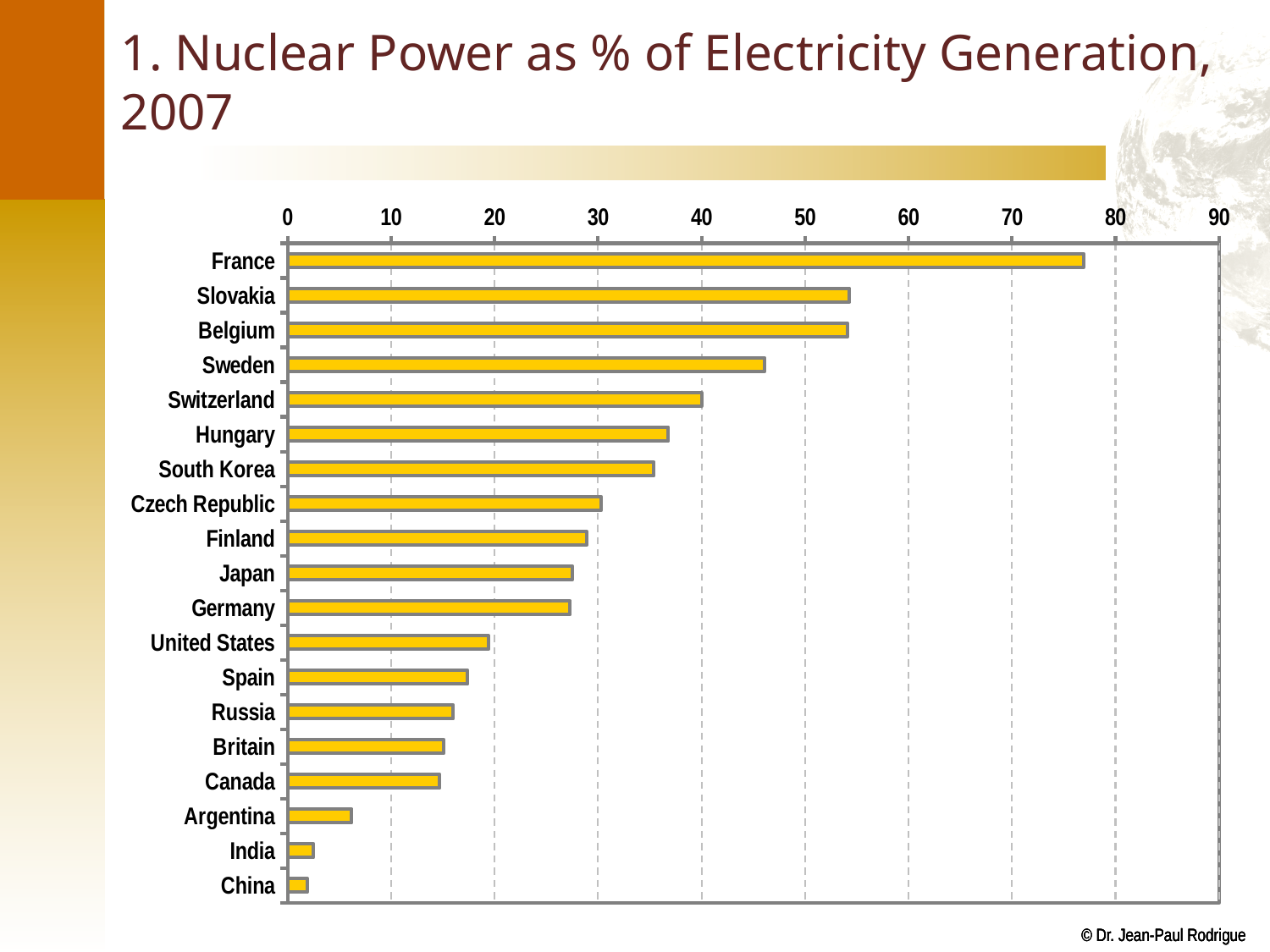
Do the bar values rise or fall going from the top of the chart to the bottom? fall Is the value for Spain greater or less than 20? less Which has a larger value, Sweden or Hungary? Sweden Is the value for Hungary greater or less than 40? less Which has a larger value, Argentina or Canada? Canada Is the value for Argentina greater or less than 10? less How many countries are shown in the chart? 19 Which country has the highest share of nuclear power in electricity generation? France What kind of chart is shown on the slide? bar chart